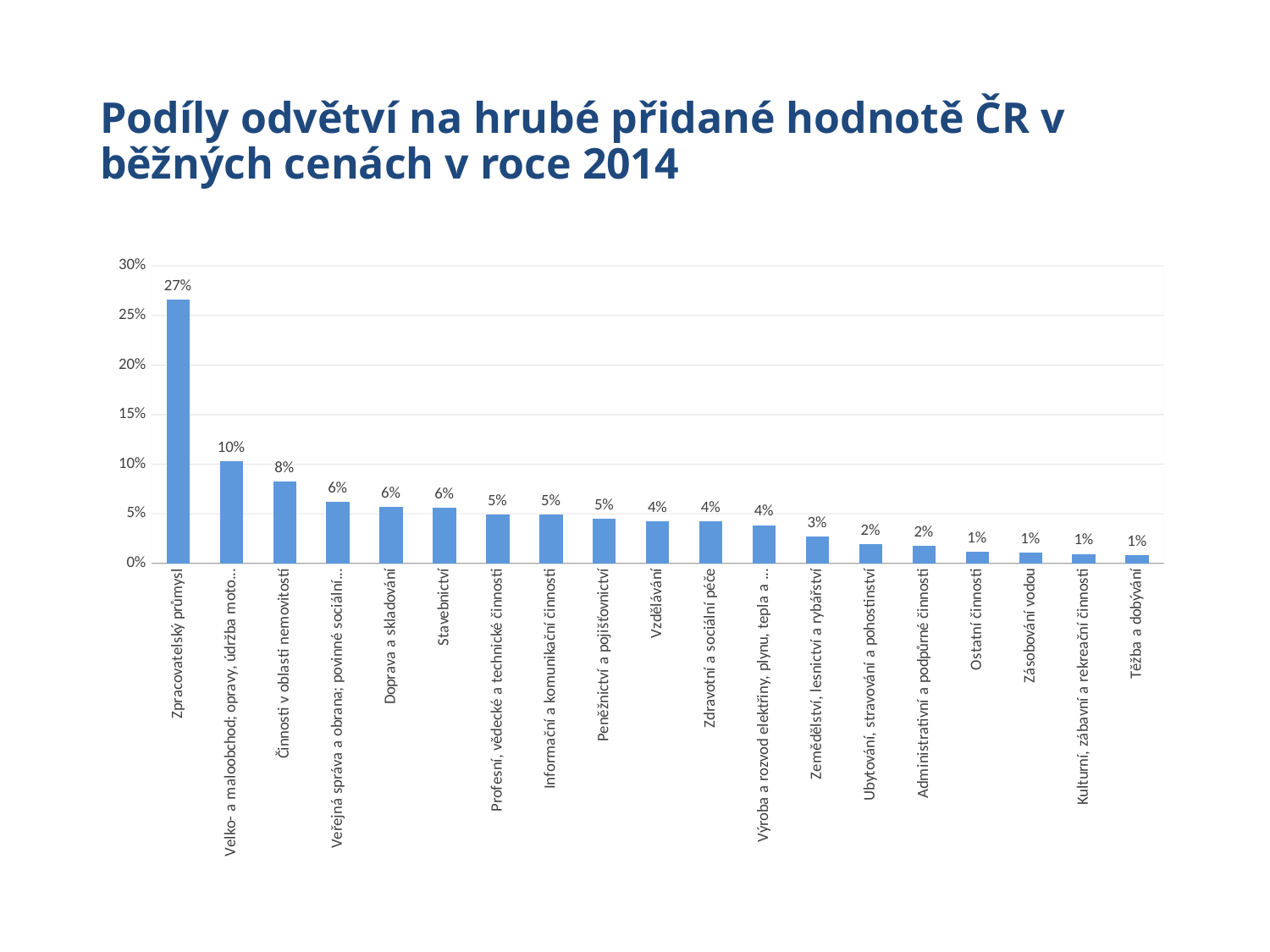
What type of chart is shown on the slide? bar chart Which category has the highest value? Zpracovatelský průmysl How many categories are shown on the x axis? 19 What is the value for Stavebnictví? 6% What is the value for Zemědělství, lesnictví a rybářství? 3% What is the value for Činnosti v oblasti nemovitostí? 8% What is the value for Zpracovatelský průmysl? 27% What is the title of the slide? Podíly odvětví na hrubé přidané hodnotě ČR v běžných cenách v roce 2014 What is the difference between the values for Zpracovatelský průmysl and Velko- a maloobchod; opravy, údržba moto...? 17% Which is larger, the value for Doprava a skladování or the value for Vzdělávání? Doprava a skladování Do the values rise or fall from left to right along the x axis? fall What is the value for Těžba a dobývání? 1%